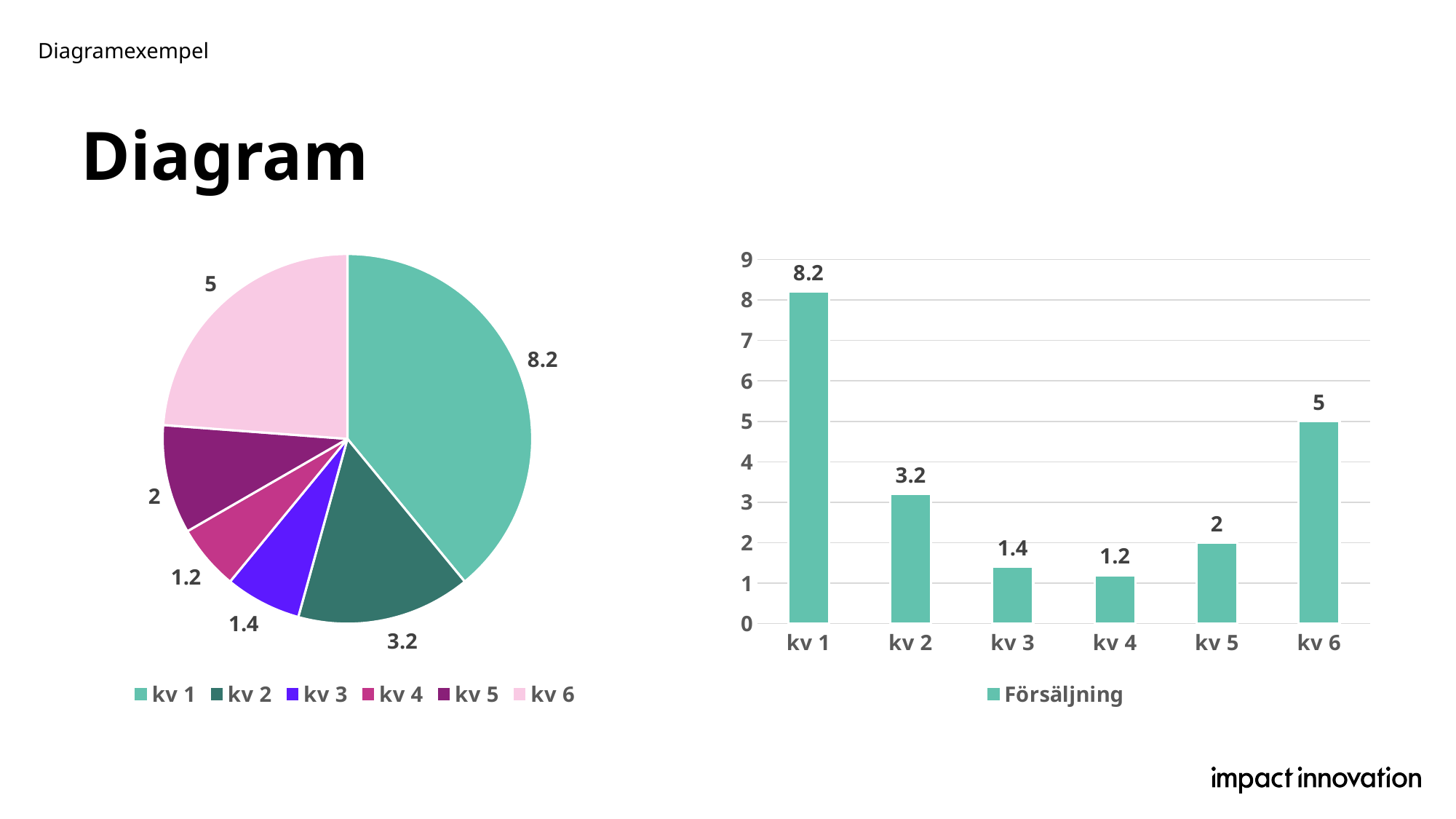
In the bar chart on the right, which category has the lowest value? kv 4 In the bar chart on the right, do the values rise or fall from kv 1 to kv 4? Fall How many series does the legend of the bar chart on the right list? 1 In the bar chart on the right, is the value for kv 6 greater or less than 4? greater In the bar chart on the right, what is the difference between the values for kv 1 and kv 6? 3.2 In the bar chart on the right, which is larger, the value for kv 2 or the value for kv 5? kv 2 In the pie chart on the left, which slice is the largest? kv 1 How many categories are shown in the bar chart on the right? 6 What is the name of the series in the legend of the bar chart on the right? Försäljning In the bar chart on the right, what is the value for kv 1? 8.2 What kind of chart is on the left side of the slide? Pie chart In the pie chart on the left, what value is shown for the kv 6 slice? 5